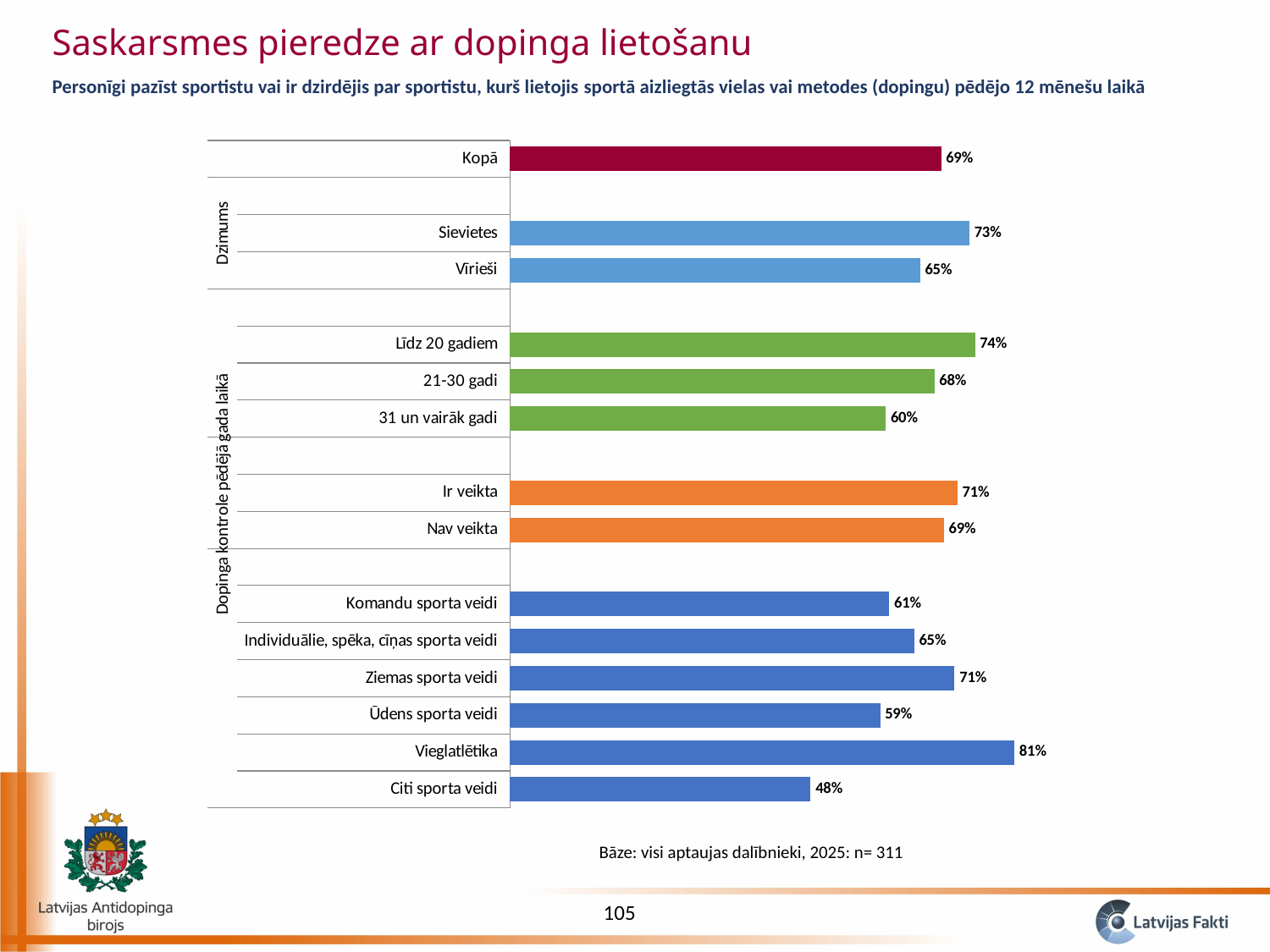
How many bars are plotted in the chart? 14 What is the difference between the values for Vieglatlētika and Ūdens sporta veidi? 22% What is the value for Citi sporta veidi? 48% Which category has the highest value? Vieglatlētika What is the value for Sievietes? 73% What is the value for Līdz 20 gadiem? 74% What is the value for Kopā? 69% What kind of chart is shown on the slide? Bar chart What is the difference between the values for Sievietes and Vīrieši? 8% What is the value for 31 un vairāk gadi? 60% Which is larger, the value for Ir veikta or the value for Nav veikta? Ir veikta Which category has the lowest value? Citi sporta veidi